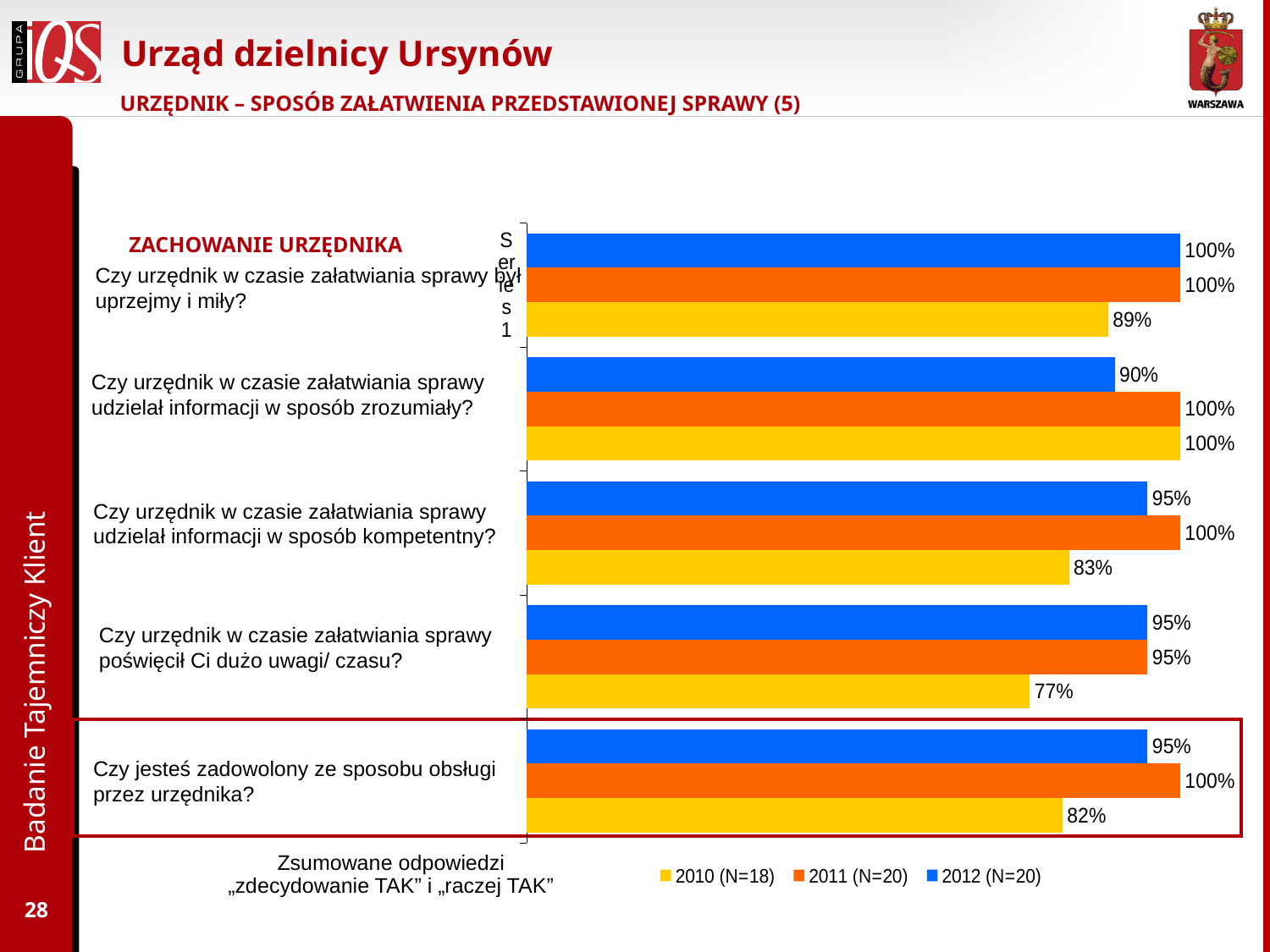
Which question has the lowest 2010 (N=18) value? Czy urzędnik w czasie załatwiania sprawy poświęcił Ci dużo uwagi/ czasu? What is the difference between the 2012 (N=20) and 2010 (N=18) values for "Czy jesteś zadowolony ze sposobu obsługi przez urzędnika?"? 13 percentage points What is the 2012 (N=20) value for "Czy urzędnik w czasie załatwiania sprawy udzielał informacji w sposób zrozumiały?"? 90% Which colour represents the 2011 (N=20) series in the chart? orange What type of chart is shown on the slide? bar chart What is the 2011 (N=20) value for "Czy jesteś zadowolony ze sposobu obsługi przez urzędnika?"? 100% What is the 2010 (N=18) value for "Czy urzędnik w czasie załatwiania sprawy poświęcił Ci dużo uwagi/ czasu?"? 77% For "Czy jesteś zadowolony ze sposobu obsługi przez urzędnika?", which is larger: the 2012 (N=20) value or the 2010 (N=18) value? 2012 (N=20) How many series does the chart legend list? 3 What is the 2010 (N=18) value for "Czy urzędnik w czasie załatwiania sprawy był uprzejmy i miły?"? 89% What is the difference between the 2011 (N=20) and 2010 (N=18) values for "Czy urzędnik w czasie załatwiania sprawy udzielał informacji w sposób kompetentny?"? 17 percentage points How many question categories are plotted in the chart? 5